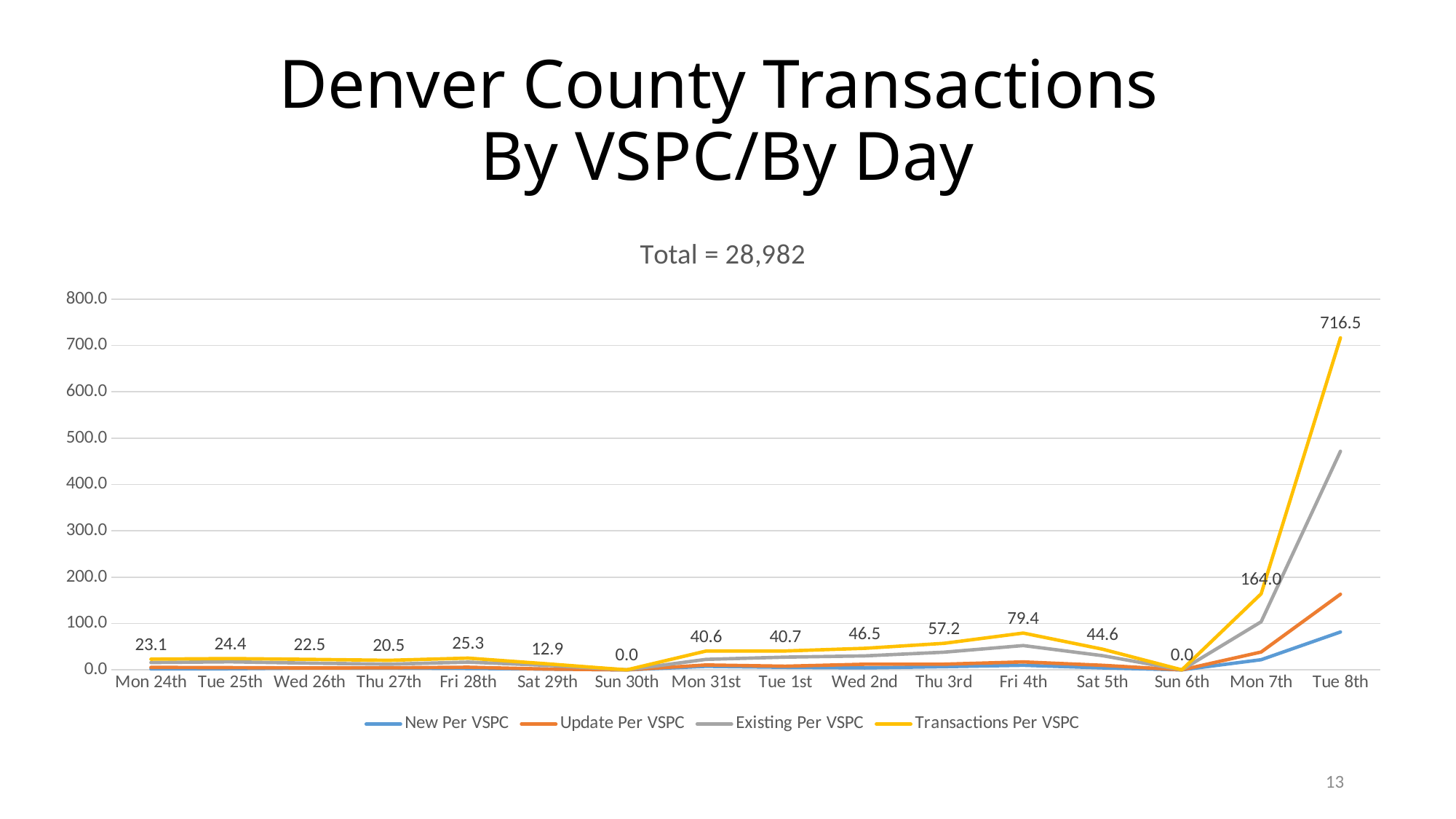
What kind of chart is shown on the slide? line chart What is the Transactions Per VSPC value on Tue 8th? 716.5 Does Transactions Per VSPC rise or fall from Sun 6th to Tue 8th? rise What is the difference in Transactions Per VSPC between Tue 8th and Mon 7th? 552.5 Which day has the larger Transactions Per VSPC value, Thu 3rd or Sat 5th? Thu 3rd Is the Existing Per VSPC value on Tue 8th greater or less than 400? greater What is the Transactions Per VSPC value on Mon 7th? 164.0 What total is stated above the chart? Total = 28,982 How many days are plotted along the x axis? 16 On which day is Transactions Per VSPC highest? Tue 8th How many series does the legend list? 4 What is the Transactions Per VSPC value on Fri 4th? 79.4